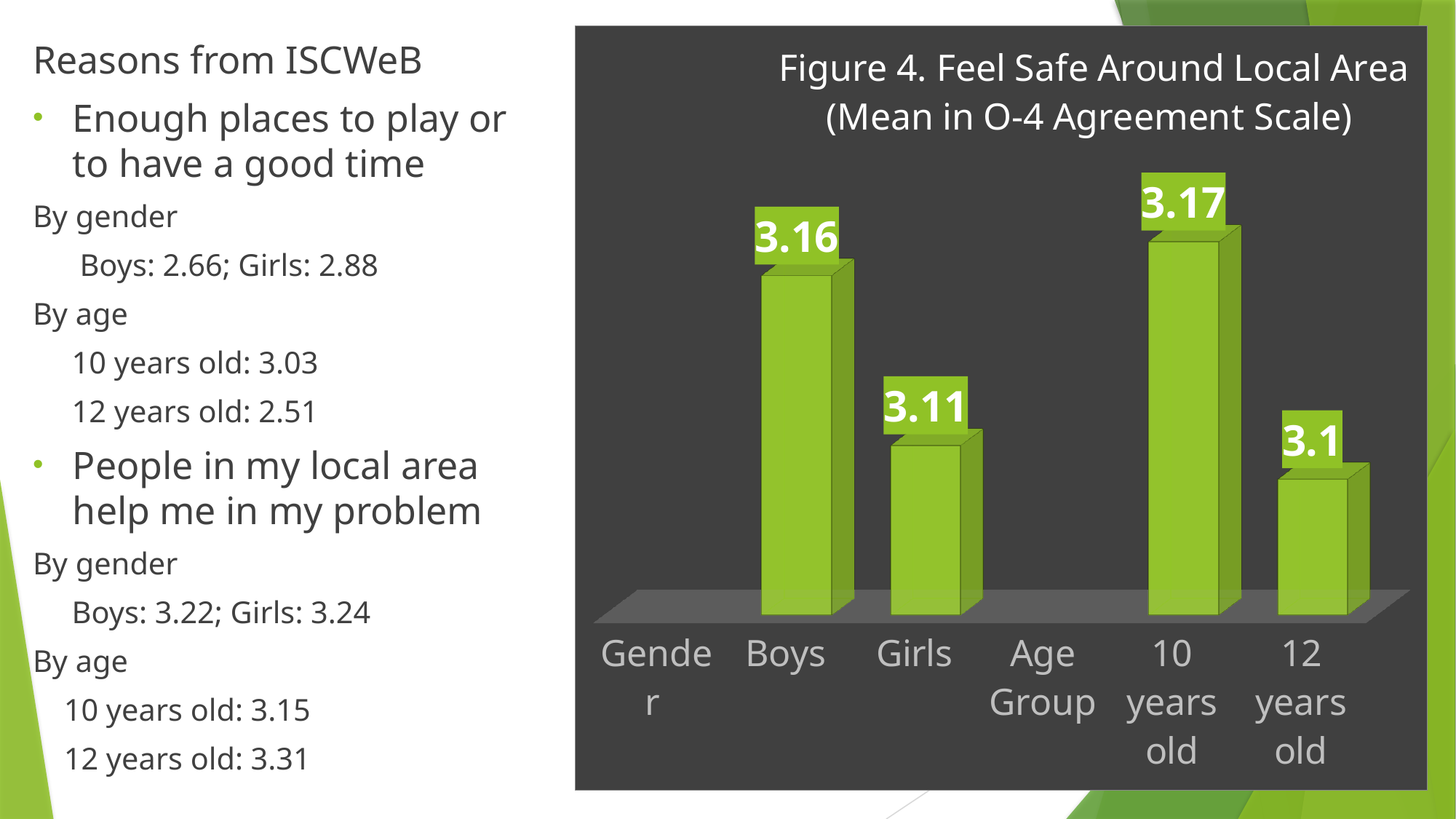
What is the value for Girls in Figure 4? 3.11 Which is larger in Figure 4, the value for Boys or the value for Girls? Boys What is the difference between the values for 10 years old and 12 years old in Figure 4? 0.07 Which bar has the lowest value in Figure 4? 12 years old Which bar has the highest value in Figure 4? 10 years old What is the value for 10 years old in Figure 4? 3.17 What is the difference between the values for Boys and Girls in Figure 4? 0.05 What kind of chart is Figure 4? bar chart What is the value for Boys in Figure 4? 3.16 What is the value for 12 years old in Figure 4? 3.1 How many bars are plotted in Figure 4? 4 What is the title of the chart on the slide? Figure 4. Feel Safe Around Local Area (Mean in O-4 Agreement Scale)